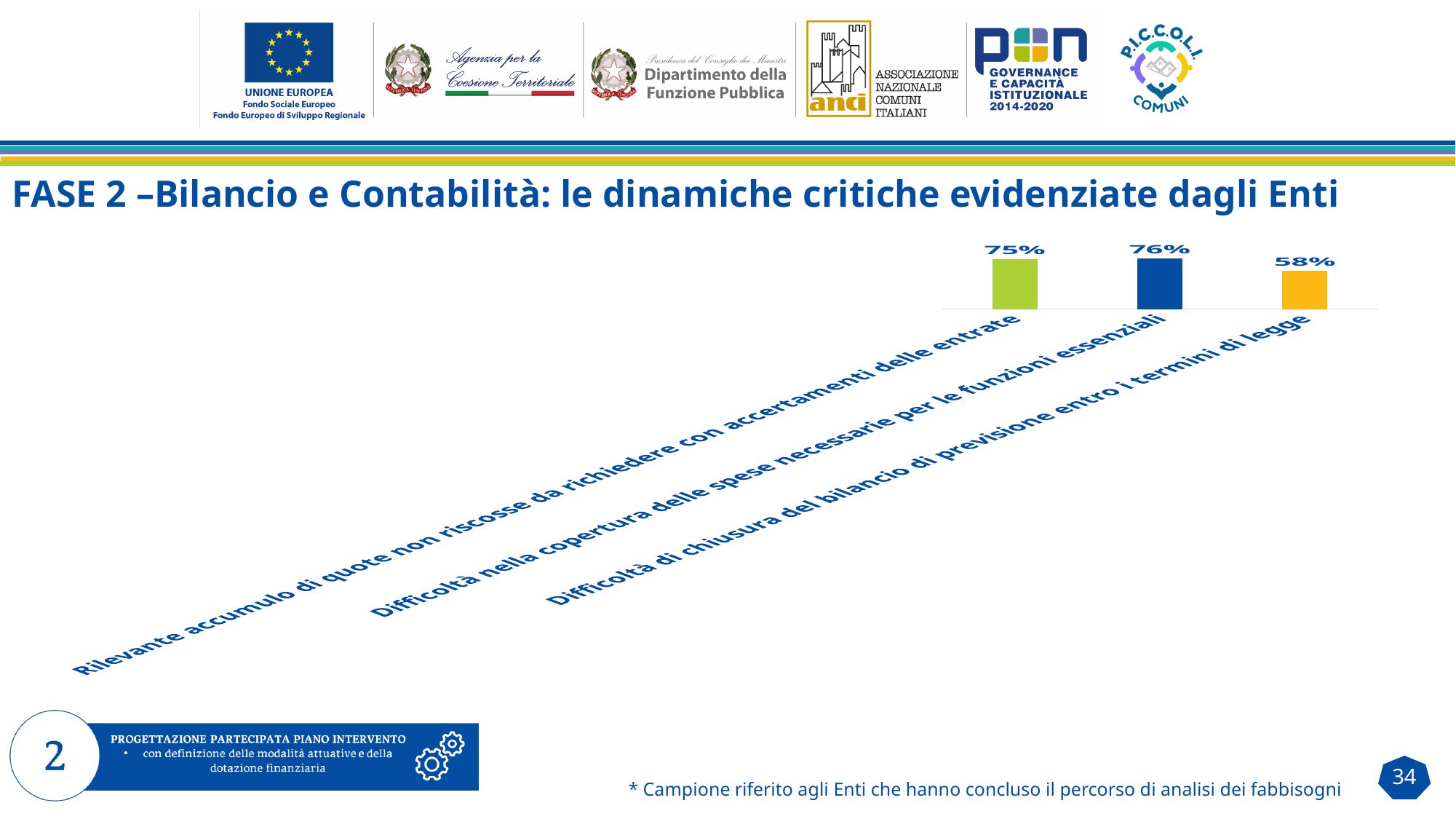
What colour is the bar for 'Rilevante accumulo di quote non riscosse da richiedere con accertamenti delle entrate'? Green What is the difference between the percentage for 'Difficoltà nella copertura delle spese necessarie per le funzioni essenziali' and the percentage for 'Difficoltà di chiusura del bilancio di previsione entro i termini di legge'? 18% Which is larger: the percentage for 'Rilevante accumulo di quote non riscosse da richiedere con accertamenti delle entrate' or the percentage for 'Difficoltà di chiusura del bilancio di previsione entro i termini di legge'? Rilevante accumulo di quote non riscosse da richiedere con accertamenti delle entrate What colour is the bar for 'Difficoltà di chiusura del bilancio di previsione entro i termini di legge'? Yellow Which category has the lowest percentage in the chart? Difficoltà di chiusura del bilancio di previsione entro i termini di legge How many categories are plotted in the chart? 3 Which category has the highest percentage in the chart? Difficoltà nella copertura delle spese necessarie per le funzioni essenziali What is the difference between the percentage for 'Rilevante accumulo di quote non riscosse da richiedere con accertamenti delle entrate' and the percentage for 'Difficoltà di chiusura del bilancio di previsione entro i termini di legge'? 17% What percentage is shown for 'Rilevante accumulo di quote non riscosse da richiedere con accertamenti delle entrate'? 75% What kind of chart is shown on the slide? Bar chart What percentage is shown for 'Difficoltà nella copertura delle spese necessarie per le funzioni essenziali'? 76% What percentage is shown for 'Difficoltà di chiusura del bilancio di previsione entro i termini di legge'? 58%